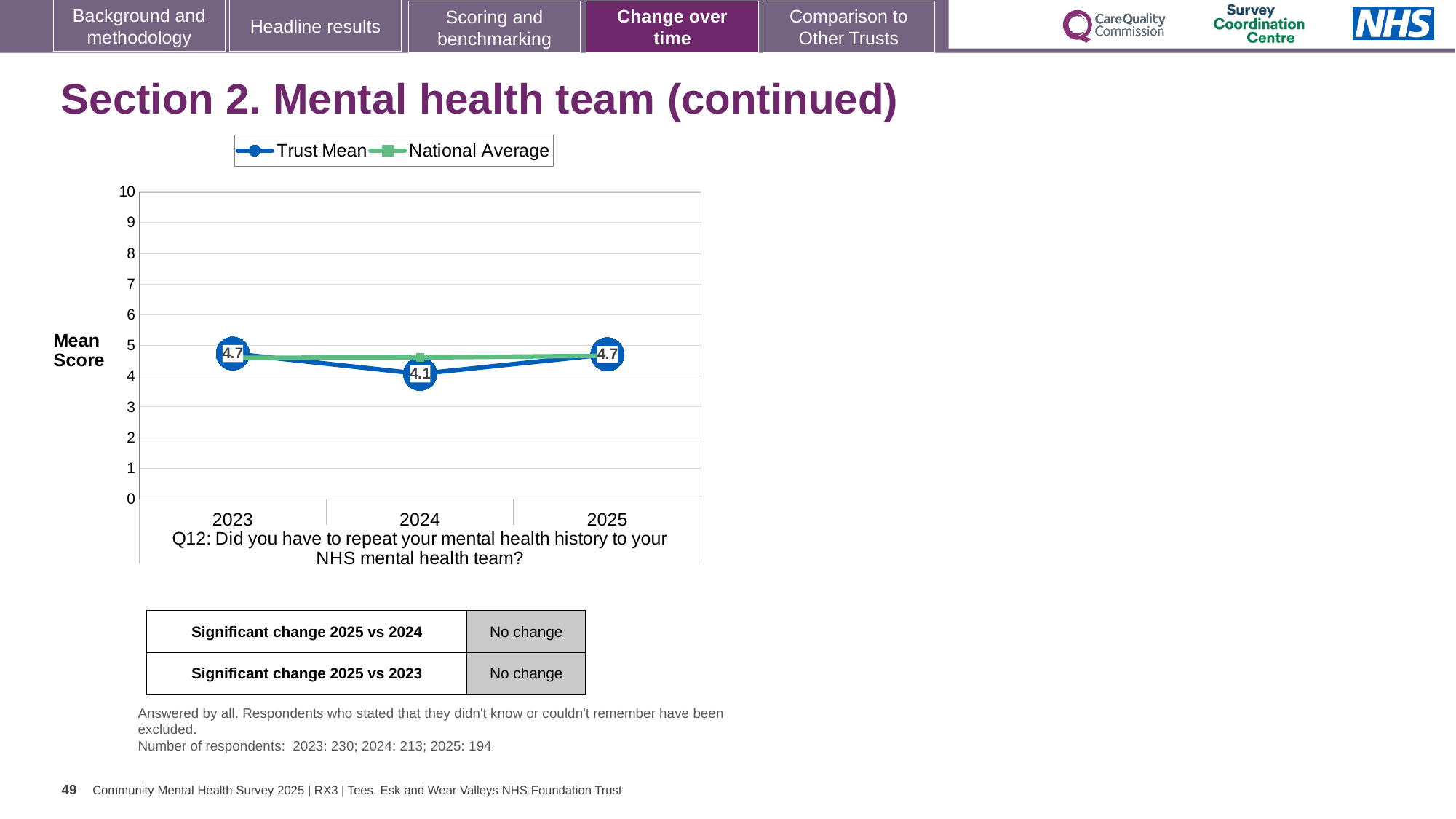
What is the Trust Mean score for 2023? 4.7 In which year is the Trust Mean score lowest? 2024 How many years are shown on the x axis of the chart? 3 Is the National Average value for 2024 greater or less than 3? greater What is the difference between the Trust Mean scores for 2023 and 2024? 0.6 What kind of chart is shown on the slide? Line chart How many series does the chart legend list? 2 What is the Trust Mean score for 2025? 4.7 Which is larger, the Trust Mean score for 2024 or for 2025? 2025 Is the National Average value for 2025 greater or less than 6? less What is the Trust Mean score for 2024? 4.1 What is the label on the y axis of the chart? Mean Score